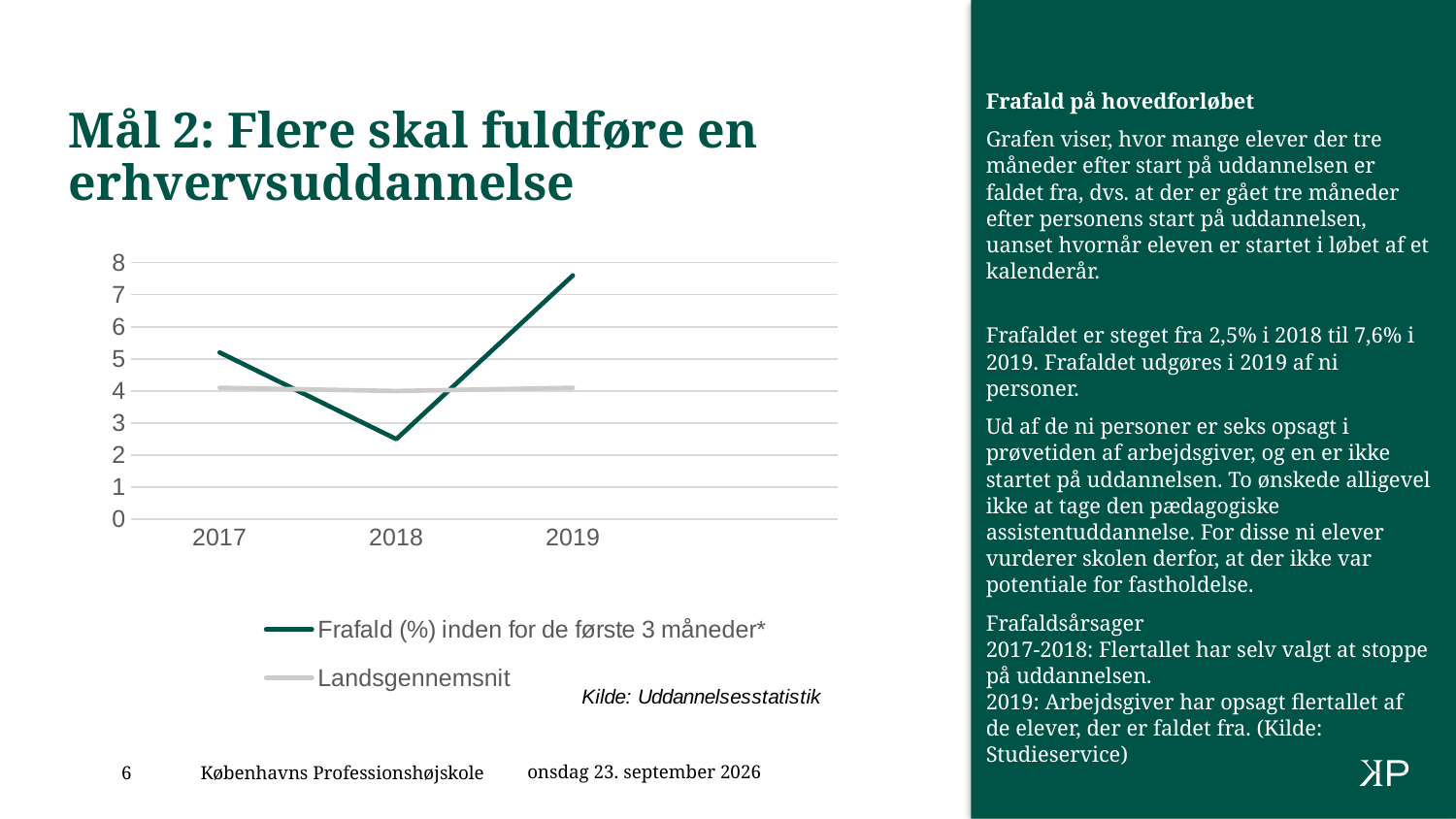
Is the value for 'Frafald (%) inden for de første 3 måneder*' in 2019 greater or less than 7? greater In which year is the value for 'Frafald (%) inden for de første 3 måneder*' lowest? 2018 In 2018, which series has the larger value: 'Frafald (%) inden for de første 3 måneder*' or 'Landsgennemsnit'? Landsgennemsnit Does the 'Frafald (%) inden for de første 3 måneder*' line rise or fall from 2018 to 2019? rise How many series does the chart legend list? 2 Is the value for 'Frafald (%) inden for de første 3 måneder*' in 2017 greater or less than 4? greater Is the value for 'Landsgennemsnit' in 2019 greater or less than 5? less In 2019, which series has the larger value: 'Frafald (%) inden for de første 3 måneder*' or 'Landsgennemsnit'? Frafald (%) inden for de første 3 måneder* In which year is the value for 'Frafald (%) inden for de første 3 måneder*' highest? 2019 What kind of chart is shown on the slide? line chart How many years are shown on the x axis of the chart? 3